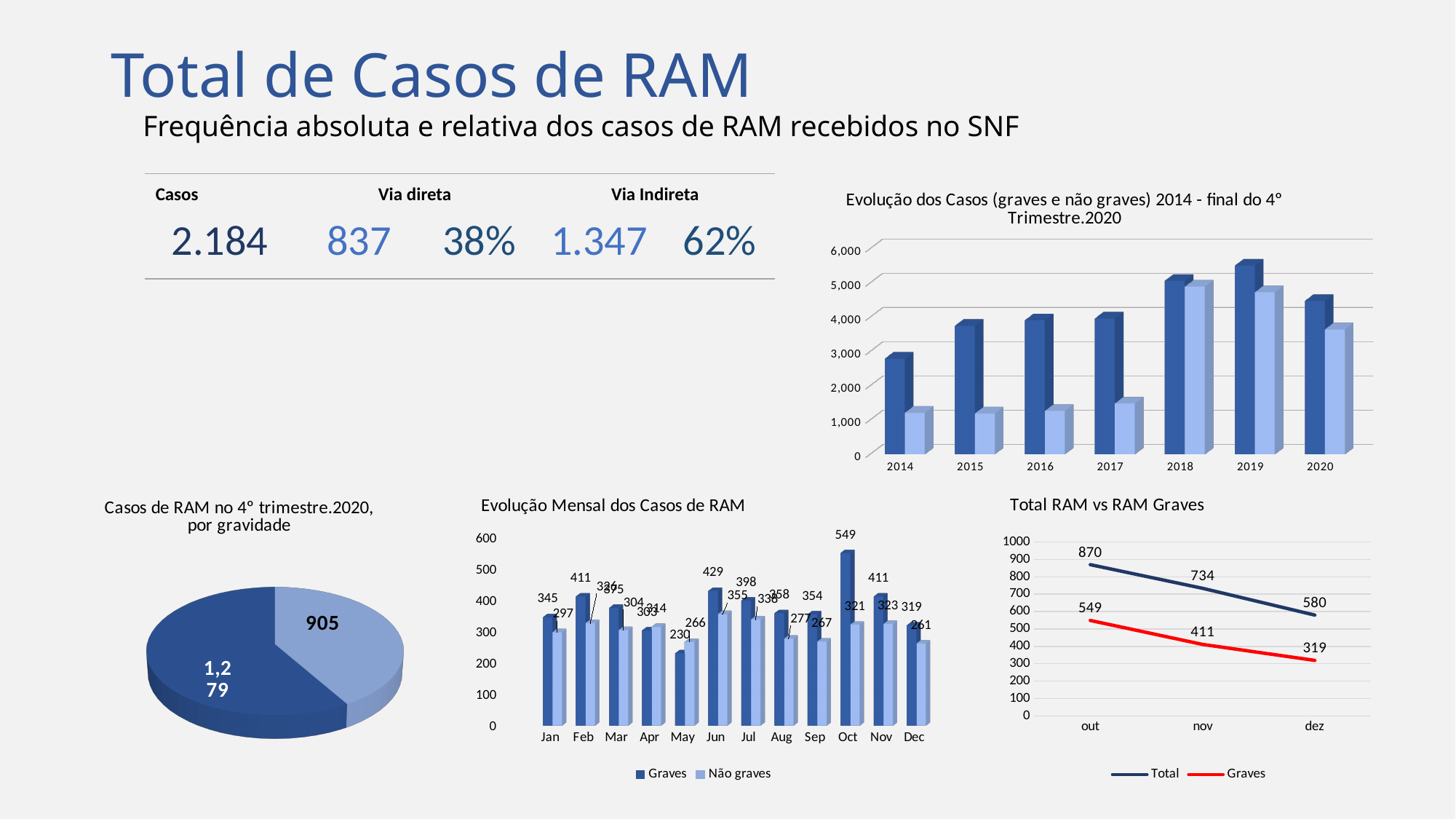
In the 'Evolução Mensal dos Casos de RAM' chart, which month has the lowest Graves value? May In the 'Total RAM vs RAM Graves' chart, what is the Graves value for dez? 319 In the 'Total RAM vs RAM Graves' chart, what is the difference between Total and Graves in out? 321 In the 'Evolução Mensal dos Casos de RAM' chart, what is the difference between Graves and Não graves in Oct? 228 In the 'Evolução dos Casos (graves e não graves) 2014 - final do 4° Trimestre.2020' chart, is the dark blue bar for 2014 greater or less than 2,000? greater In the 'Total RAM vs RAM Graves' chart, what is the Total value for nov? 734 In the 'Evolução dos Casos (graves e não graves) 2014 - final do 4° Trimestre.2020' chart, which year has the tallest dark blue bar? 2019 In the 'Evolução Mensal dos Casos de RAM' chart, what is the Não graves value for May? 266 In the 'Total RAM vs RAM Graves' chart, do the Total values rise or fall from out to dez? fall In the 'Evolução Mensal dos Casos de RAM' chart, which month has the highest Graves value? Oct How many months are shown on the x axis of the 'Evolução Mensal dos Casos de RAM' chart? 12 In the 'Casos de RAM no 4° trimestre.2020, por gravidade' pie chart, which slice is larger, 1,279 or 905? 1,279